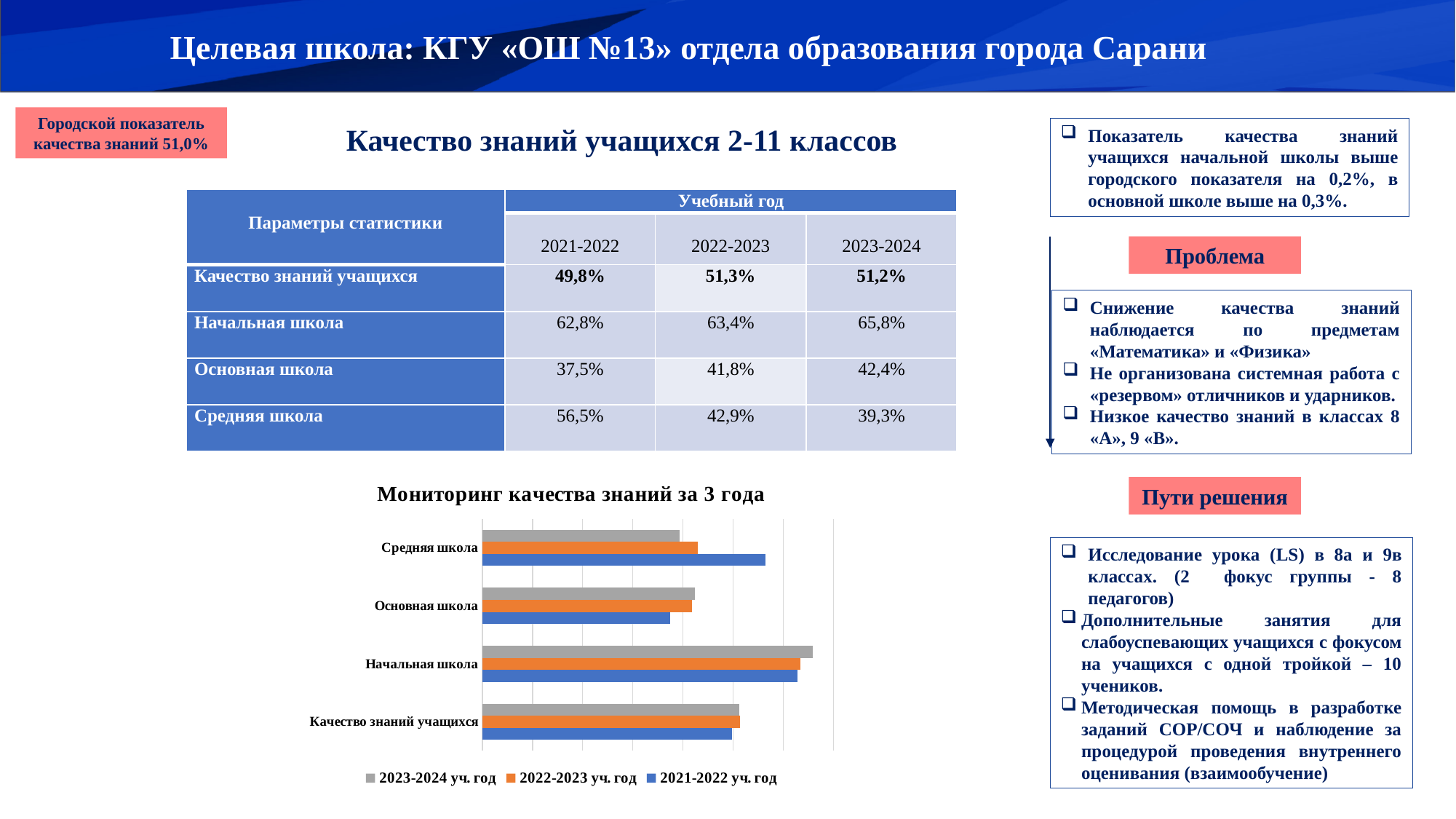
According to the slide, what is the value for Начальная школа in 2023-2024 plotted in the chart "Мониторинг качества знаний за 3 года"? 65,8% In the chart "Мониторинг качества знаний за 3 года", which colour represents the 2022-2023 уч. год series? orange What kind of chart is "Мониторинг качества знаний за 3 года"? bar chart In the chart "Мониторинг качества знаний за 3 года", do the bars for Начальная школа rise or fall from 2021-2022 to 2023-2024? rise According to the slide, what is the value for Средняя школа in 2021-2022 plotted in the chart "Мониторинг качества знаний за 3 года"? 56,5% In the chart "Мониторинг качества знаний за 3 года", do the bars for Средняя школа rise or fall from 2021-2022 to 2023-2024? fall How many series does the legend of the chart "Мониторинг качества знаний за 3 года" list? 3 In the chart "Мониторинг качества знаний за 3 года", for Средняя школа, which is larger: the 2021-2022 уч. год bar or the 2023-2024 уч. год bar? 2021-2022 уч. год In the chart "Мониторинг качества знаний за 3 года", which category has the longest bar for the 2023-2024 уч. год series? Начальная школа In the chart "Мониторинг качества знаний за 3 года", which category has the shortest bar for the 2023-2024 уч. год series? Средняя школа How many categories are shown on the y axis of the chart "Мониторинг качества знаний за 3 года"? 4 In the chart "Мониторинг качества знаний за 3 года", which category has the shortest bar for the 2021-2022 уч. год series? Основная школа